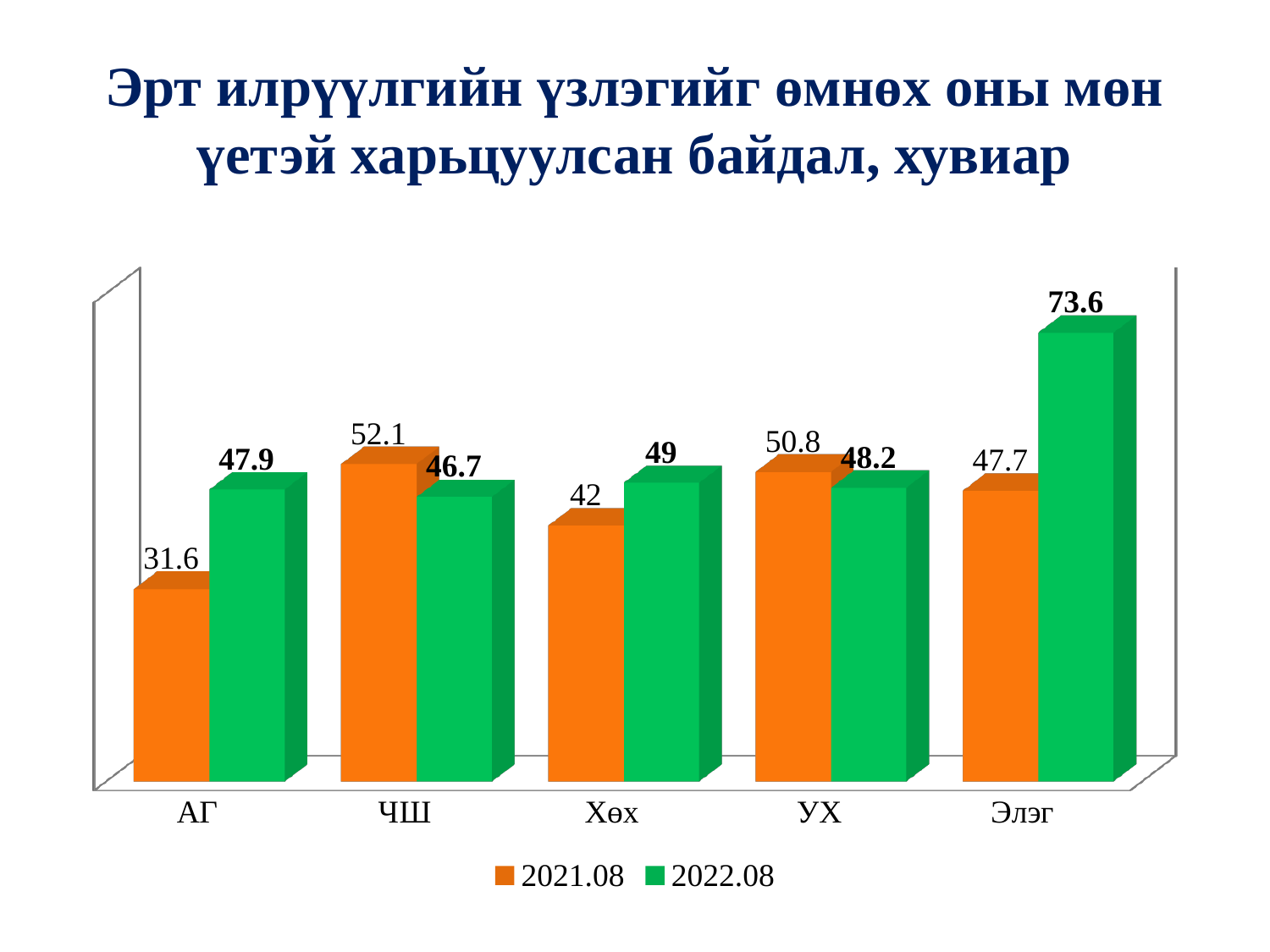
What is the value for Элэг in the 2022.08 series? 73.6 Which category has the highest value in the 2022.08 series? Элэг What is the value for УХ in the 2022.08 series? 48.2 What kind of chart is shown on the slide? Bar chart For ЧШ, which series has the larger value, 2021.08 or 2022.08? 2021.08 Which category has the lowest value in the 2021.08 series? АГ What is the difference between the 2022.08 and 2021.08 values for Элэг? 25.9 How many series does the legend list? 2 How many categories are shown on the x axis? 5 What is the value for Хөх in the 2021.08 series? 42 What is the value for АГ in the 2021.08 series? 31.6 What is the difference between the 2022.08 and 2021.08 values for АГ? 16.3